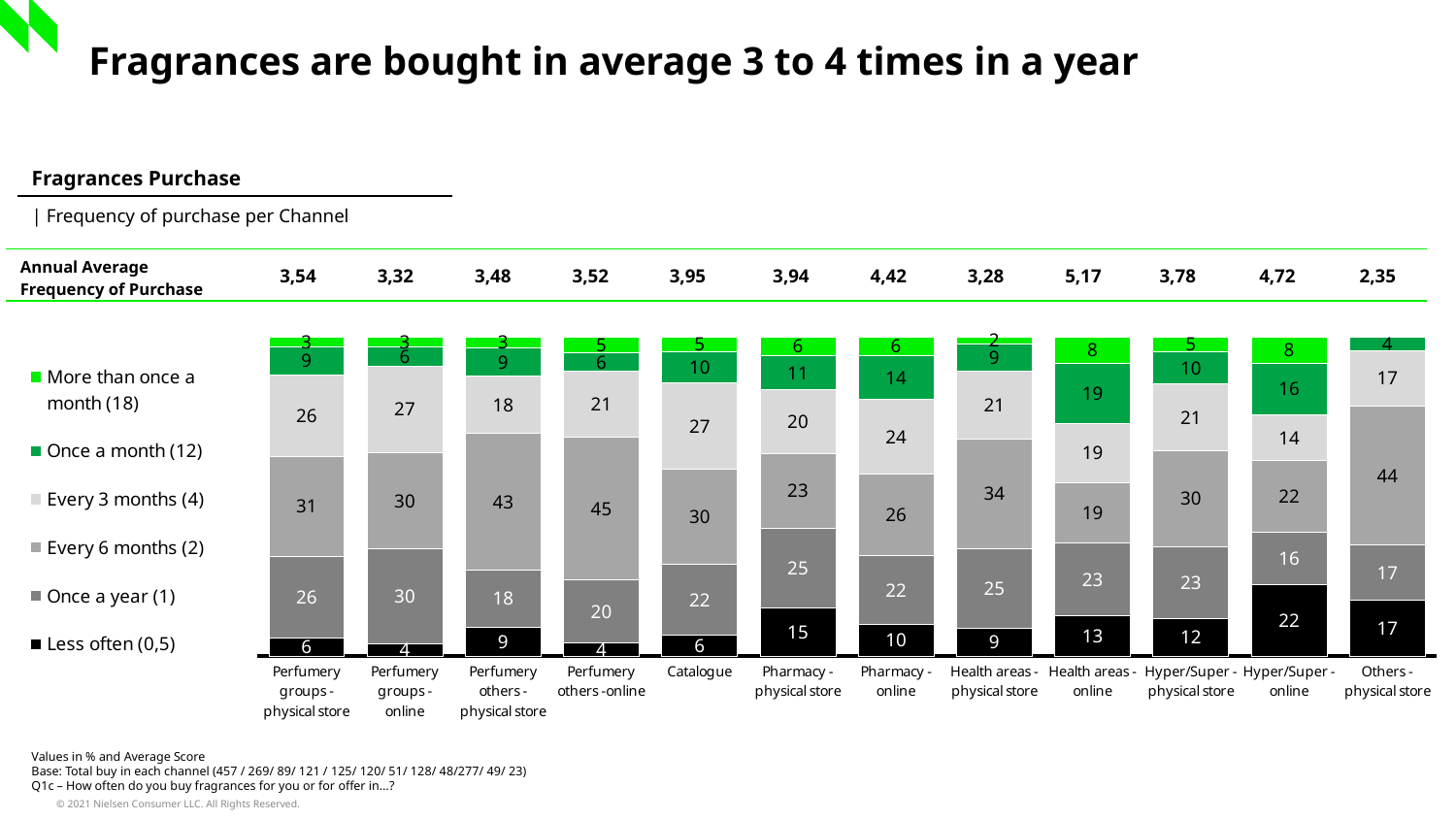
Which channel has the lowest Annual Average Frequency of Purchase? Others - physical store What is the Annual Average Frequency of Purchase for Health areas - online? 5,17 What is the 'Once a month' value for Health areas - online? 19 What weight is shown in parentheses next to the legend entry 'Less often'? 0,5 Which has a larger 'Every 6 months' value: Perfumery others - physical store or Perfumery groups - physical store? Perfumery others - physical store Which channel has the highest Annual Average Frequency of Purchase? Health areas - online What kind of chart is shown on the slide? Stacked bar chart What is the 'Less often' value for Hyper/Super - online? 22 What is the difference between the Annual Average Frequency of Purchase for Pharmacy - online and Pharmacy - physical store? 0,48 How many channels (categories) are shown along the x axis of the chart? 12 How many series does the legend of the chart list? 6 What percentage of Perfumery others - online buyers purchase fragrances every 6 months? 45